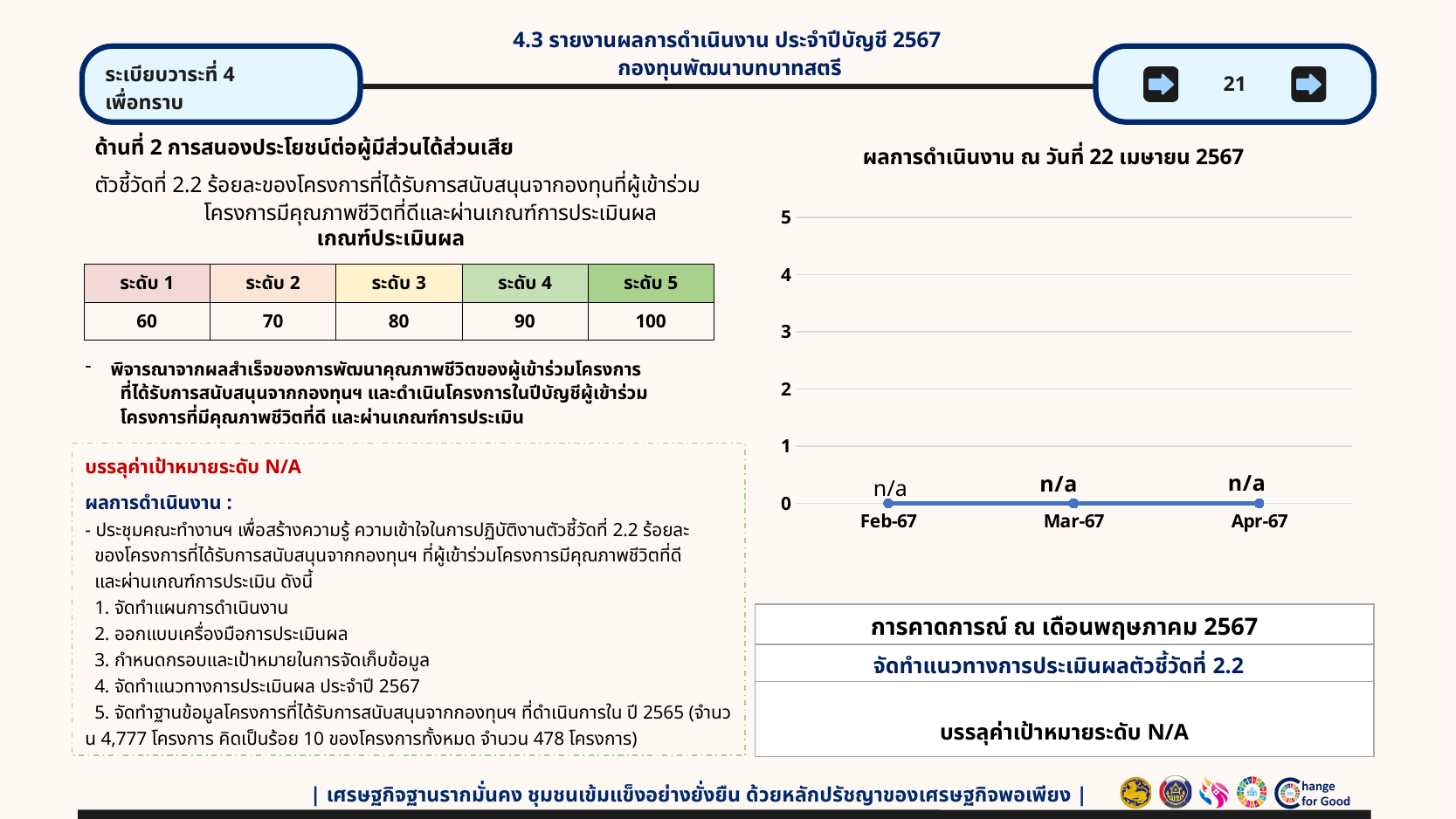
What are the category labels on the x axis of the line chart, in order? Feb-67, Mar-67, Apr-67 What is the title of the line chart? ผลการดำเนินงาน ณ วันที่ 22 เมษายน 2567 What kind of chart is shown on the slide? line chart What is the data label shown for Apr-67 on the line chart? n/a Does the line rise, fall, or stay flat from Feb-67 to Apr-67? stays flat What is the highest value shown on the y axis of the line chart? 5 How many data points are plotted on the line chart? 3 Is the plotted point for Mar-67 above or below the 1 gridline on the y axis? below What is the data label shown for Feb-67 on the line chart? n/a What is the data label shown for Mar-67 on the line chart? n/a